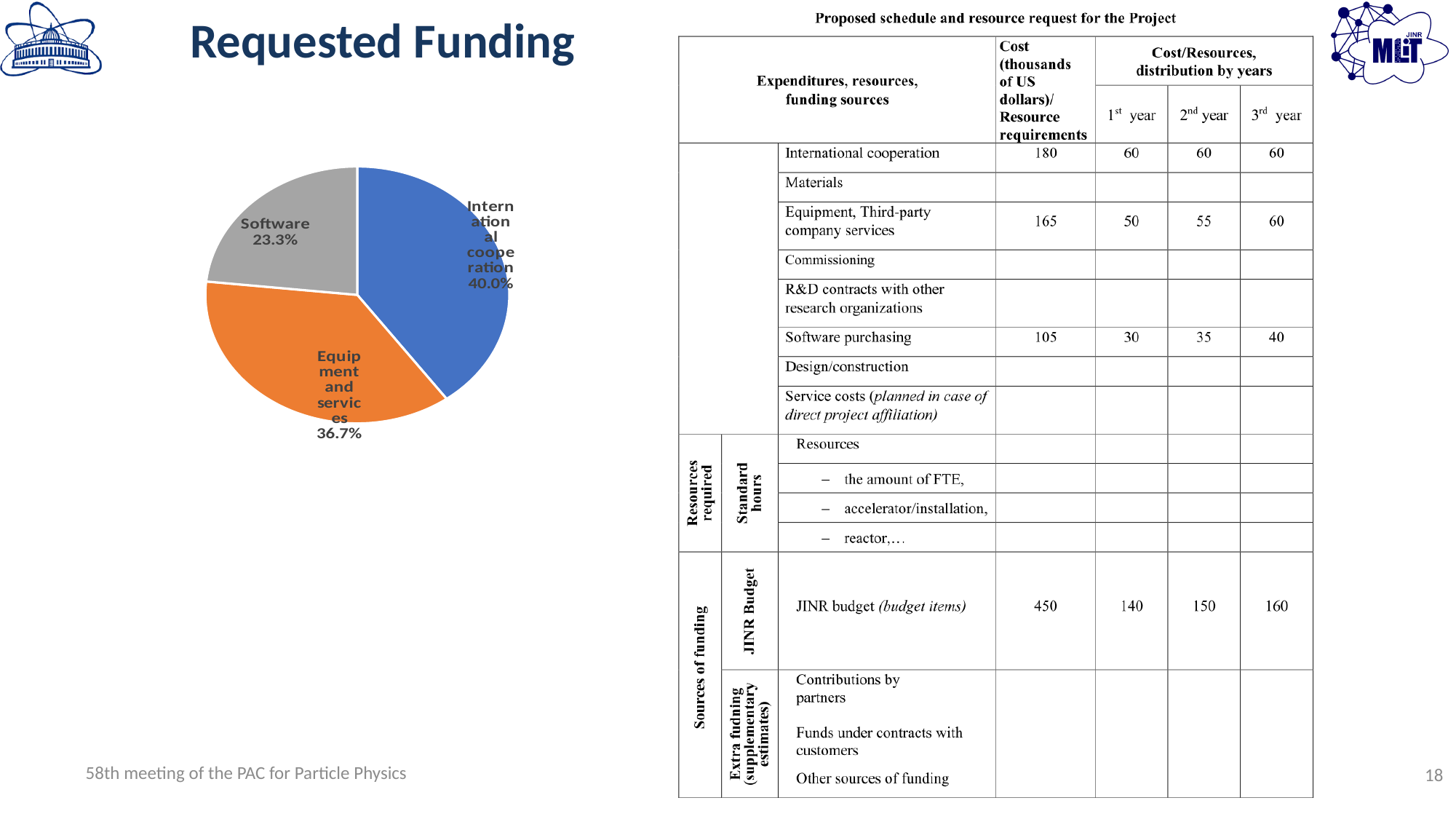
How many slices does the pie chart have? 3 What is the difference in percentage points between the Equipment and services and Software slices? 13.4 Which slice of the pie chart is the smallest? Software Which slice of the pie chart is the largest? International cooperation What share of the pie chart is International cooperation? 40.0% What is the difference in percentage points between the International cooperation and Software slices? 16.7 What share of the pie chart is Software? 23.3% What colour is the Equipment and services slice in the pie chart? orange Which is larger in the pie chart, Equipment and services or Software? Equipment and services What kind of chart is shown on the slide? pie chart What share of the pie chart is Equipment and services? 36.7% What colour is the Software slice in the pie chart? grey